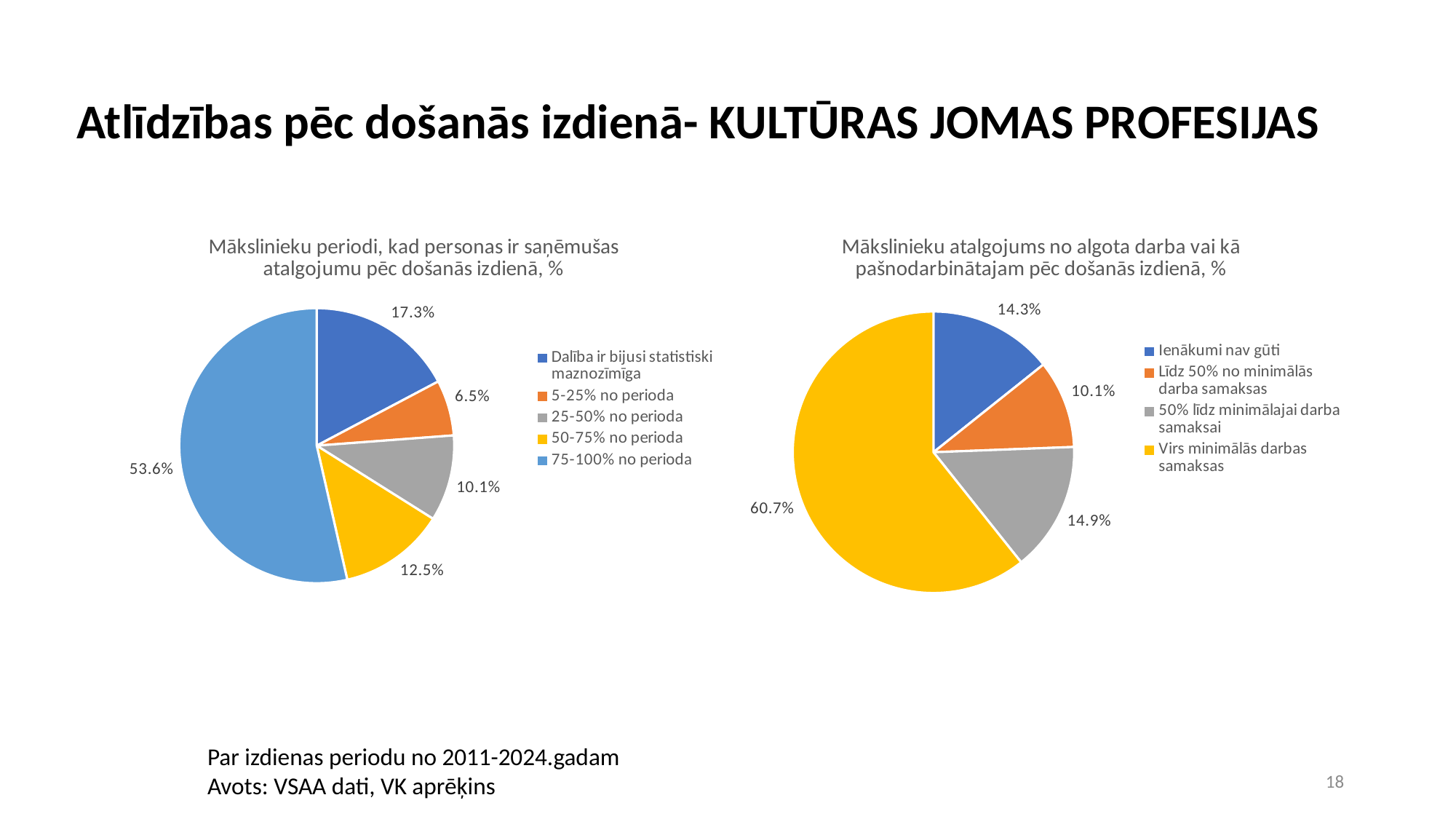
In the right chart (Mākslinieku atalgojums...), which category has the smallest share? Līdz 50% no minimālās darba samaksas In the left chart (Mākslinieku periodi...), what is the difference between '50-75% no perioda' and '25-50% no perioda'? 2.4 percentage points In the left chart (Mākslinieku periodi...), what is the value for '5-25% no perioda'? 6.5% In the left chart (Mākslinieku periodi...), which category has the smallest share? 5-25% no perioda In the left chart (Mākslinieku periodi, kad personas ir saņēmušas atalgojumu pēc došanās izdienā, %), what is the value for '75-100% no perioda'? 53.6% In the right chart (Mākslinieku atalgojums...), which is larger: '50% līdz minimālajai darba samaksai' or 'Ienākumi nav gūti'? 50% līdz minimālajai darba samaksai In the left chart (Mākslinieku periodi...), which category has the largest share? 75-100% no perioda In the right chart (Mākslinieku atalgojums...), how many slices does the pie have? 4 In the left chart (Mākslinieku periodi...), how many categories does the legend list? 5 In the right chart (Mākslinieku atalgojums...), what is the value for 'Ienākumi nav gūti'? 14.3% In the right chart (Mākslinieku atalgojums no algota darba vai kā pašnodarbinātajam pēc došanās izdienā, %), what is the value for 'Virs minimālās darbas samaksas'? 60.7% What type of chart is used on this slide? Pie chart